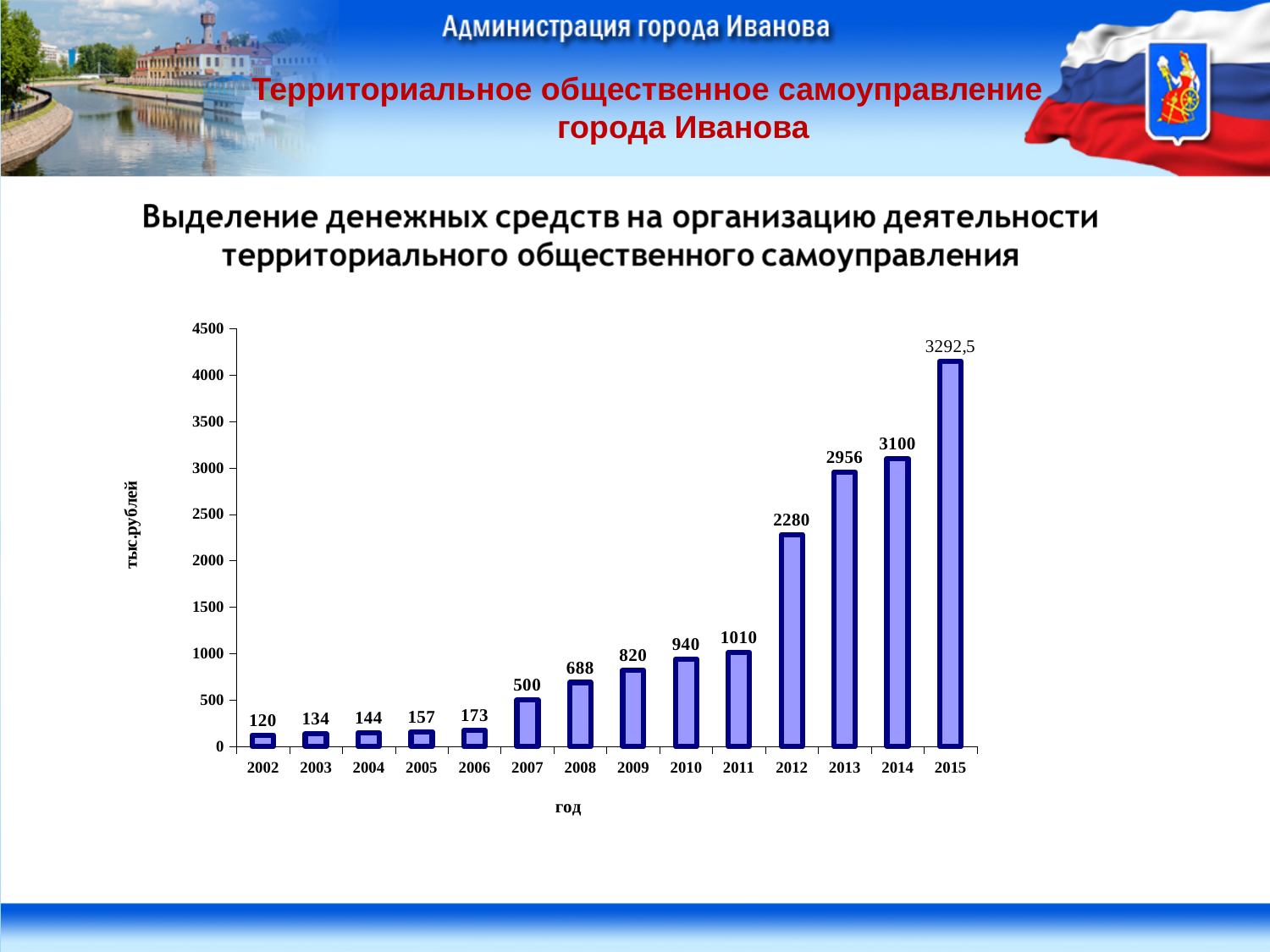
How many years are shown on the x axis? 14 What is the label of the y axis? тыс.рублей What value is shown for 2015? 3292,5 Do the values rise or fall from 2002 to 2015? rise What kind of chart is this? bar chart What is the difference between the values for 2011 and 2010? 70 What is the difference between the values for 2014 and 2013? 144 Which year has the highest value? 2015 What value is shown for 2012? 2280 What value is shown for 2007? 500 Which is larger, the value for 2009 or the value for 2008? 2009 Which year has the lowest value? 2002